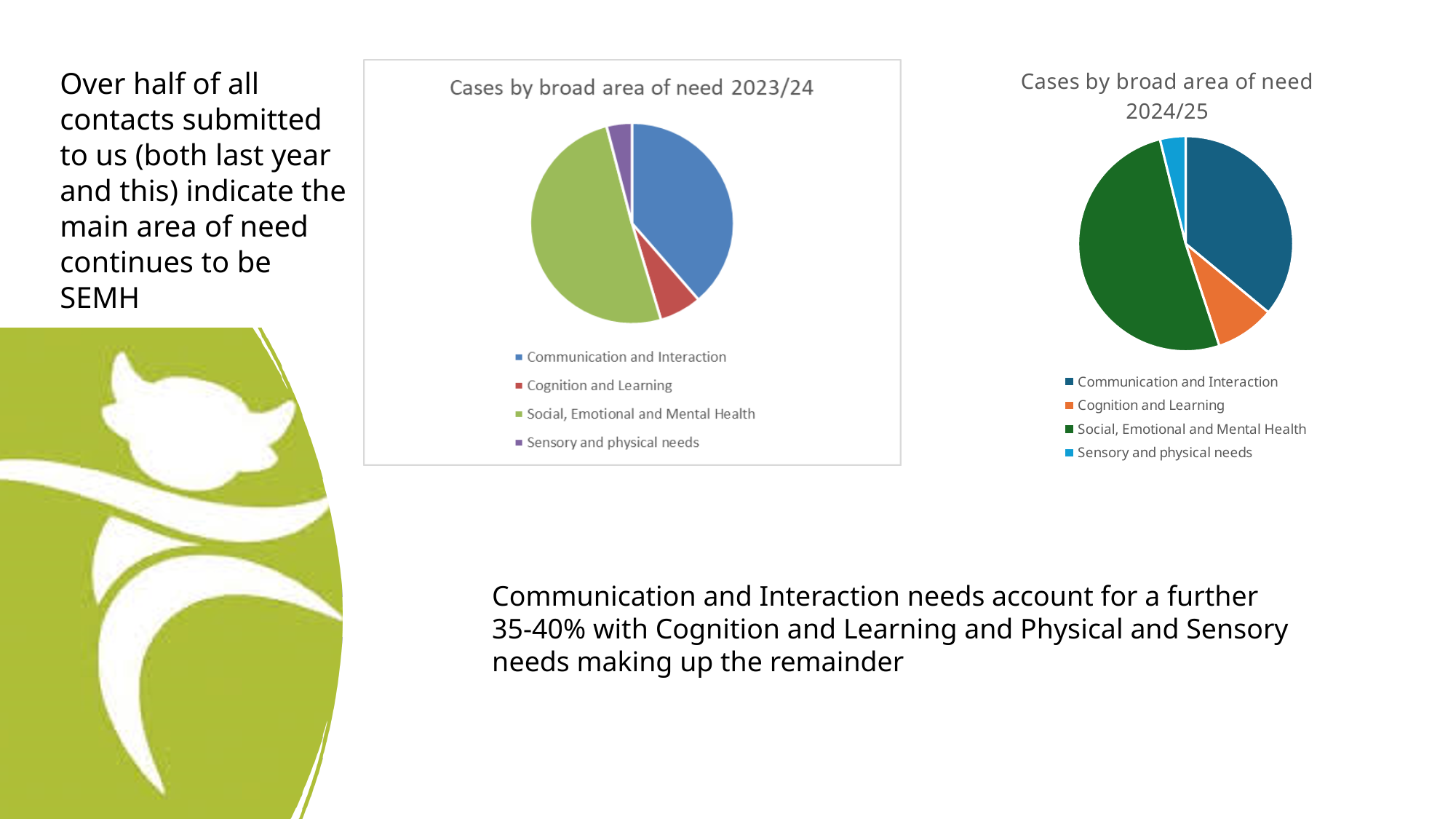
In the "Cases by broad area of need 2023/24" chart, what colour is the Social, Emotional and Mental Health slice? Green How many entries does the legend of the "Cases by broad area of need 2024/25" chart list? 4 In the "Cases by broad area of need 2023/24" chart, which area of need has the smallest slice? Sensory and physical needs What kind of chart is "Cases by broad area of need 2023/24"? Pie chart In the "Cases by broad area of need 2023/24" chart, which area of need has the largest slice? Social, Emotional and Mental Health In the "Cases by broad area of need 2023/24" chart, which is larger: Communication and Interaction or Cognition and Learning? Communication and Interaction In the "Cases by broad area of need 2024/25" chart, which area of need has the smallest slice? Sensory and physical needs In the "Cases by broad area of need 2024/25" chart, which area of need has the largest slice? Social, Emotional and Mental Health What kind of chart is "Cases by broad area of need 2024/25"? Pie chart How many areas of need are shown in the "Cases by broad area of need 2023/24" pie chart? 4 In the "Cases by broad area of need 2024/25" chart, which is larger: Social, Emotional and Mental Health or Communication and Interaction? Social, Emotional and Mental Health What is the title of the pie chart on the right of the slide? Cases by broad area of need 2024/25